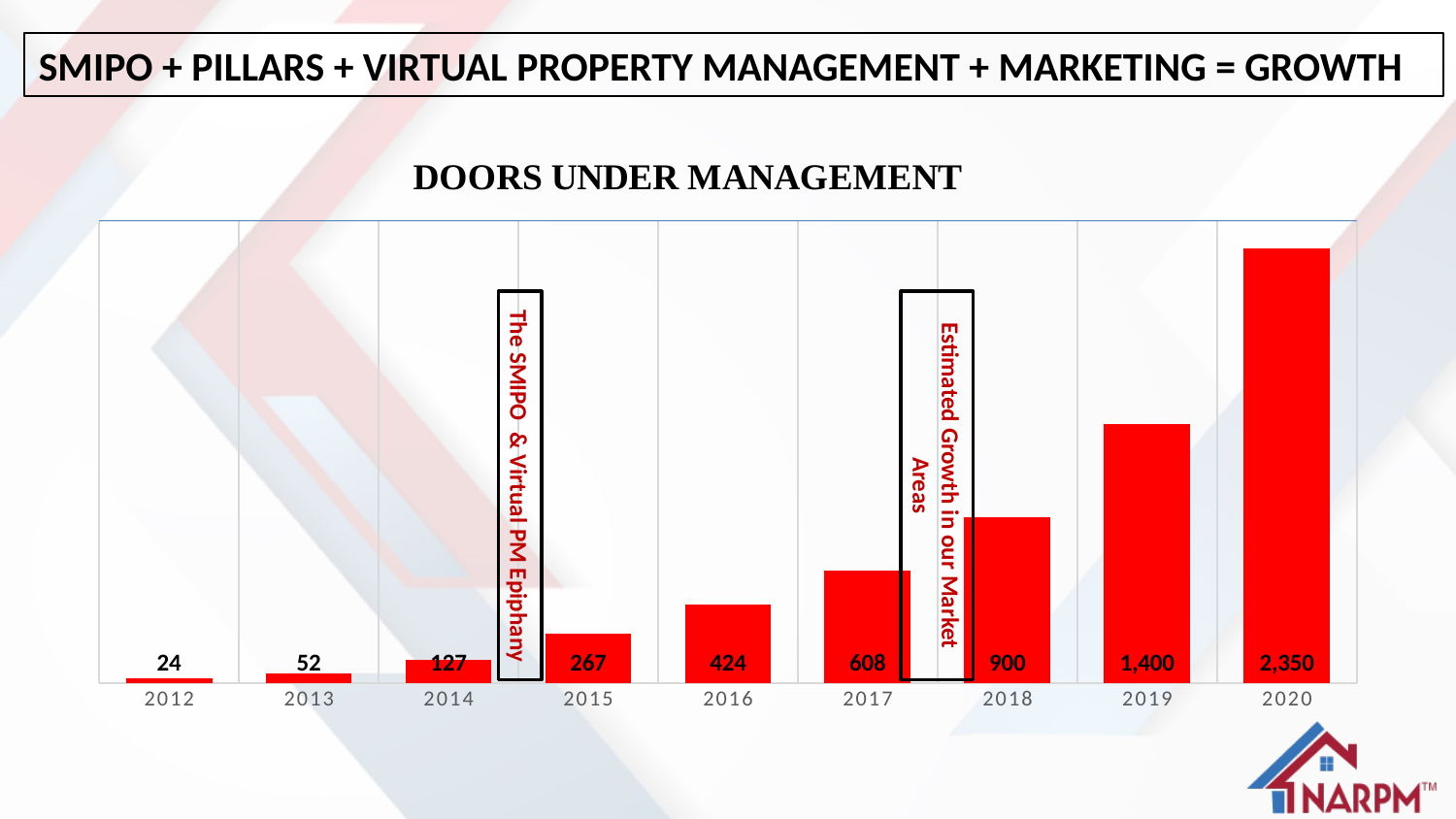
Which year has the highest number of doors under management? 2020 What is the value shown for 2012? 24 Which is larger, the value for 2015 or the value for 2014? 2015 What is the title of the chart? DOORS UNDER MANAGEMENT What kind of chart is shown on the slide? Bar chart How many doors were under management in 2019? 1,400 What is the difference between the values for 2017 and 2016? 184 What is the difference between the values for 2020 and 2019? 950 Do the values rise or fall from 2012 to 2020? Rise Which year has the lowest number of doors under management? 2012 How many years are shown on the x axis of the chart? 9 What is the value for 2016 in the Doors Under Management chart? 424